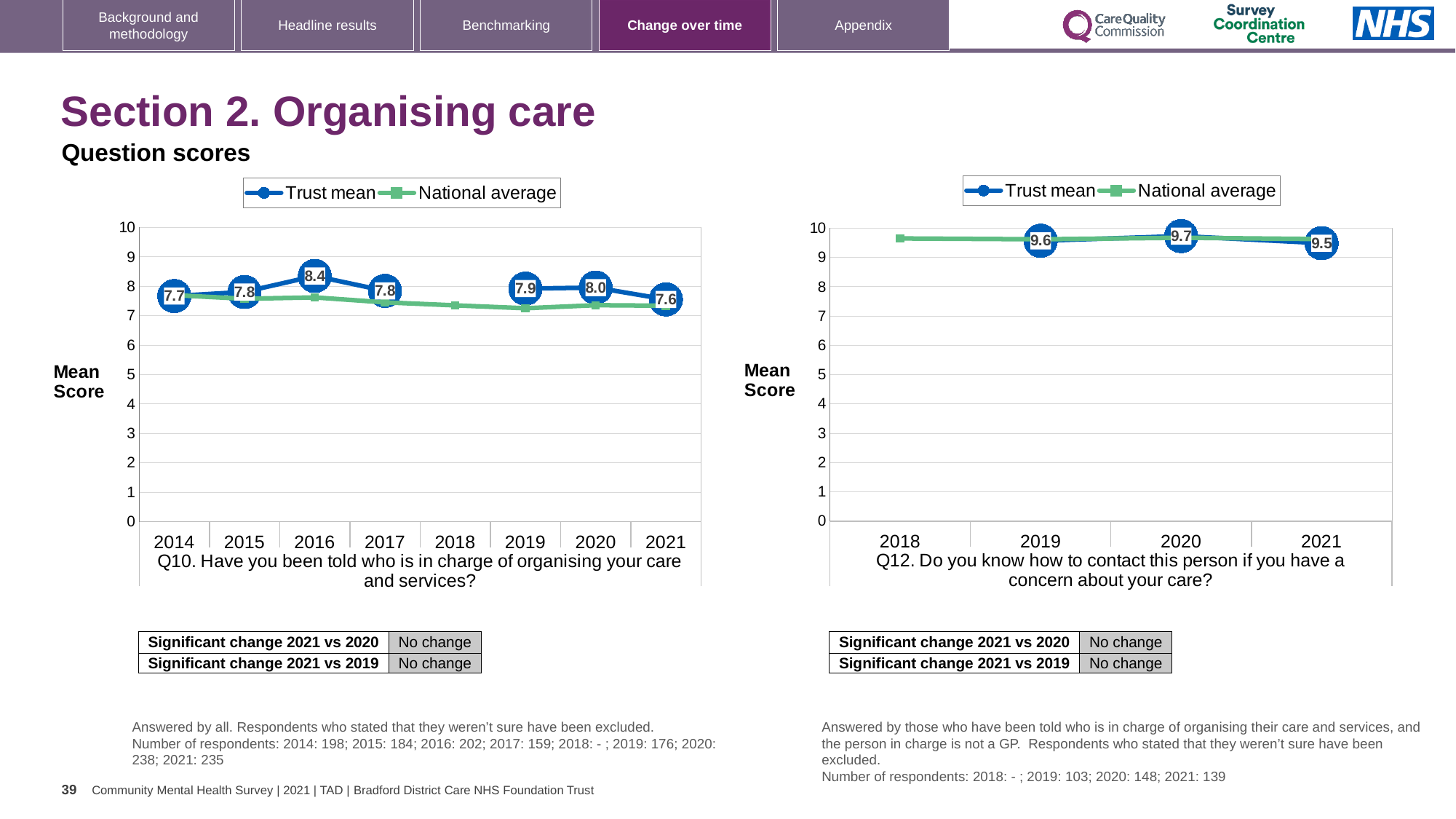
In the Q10 chart, what is the Trust mean for 2016? 8.4 In the Q10 chart, what is the difference between the Trust mean in 2020 and in 2021? 0.4 In the Q10 chart, is the National average for 2019 greater or less than 8? less In the Q10 chart, which year has the highest Trust mean? 2016 In the Q10 chart, is the Trust mean higher in 2019 or in 2021? 2019 In the Q12 chart, what is the Trust mean for 2020? 9.7 What type of chart is the Q10 chart? Line chart In the Q12 chart, which year has the lowest Trust mean? 2021 How many years are shown on the x axis of the Q12 chart? 4 In the Q12 chart, what is the difference between the Trust mean in 2020 and in 2021? 0.2 In the Q10 chart, which year has the lowest labelled Trust mean? 2021 In the Q10 chart, what is the Trust mean for 2021? 7.6